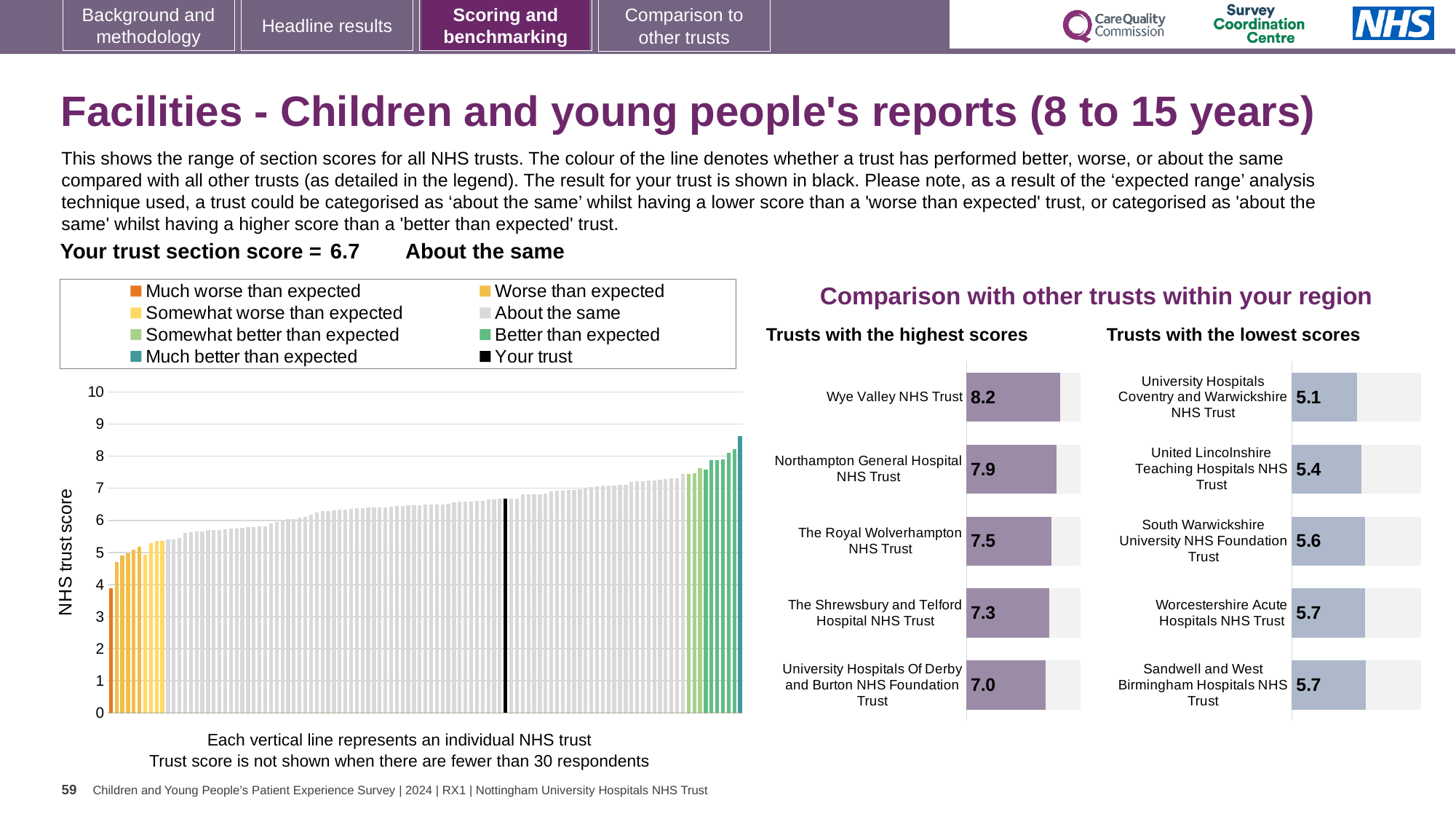
In the main chart of NHS trust scores, is the value for the black 'Your trust' bar greater or less than 6? greater In the 'Trusts with the lowest scores' chart, which trust has the lowest score? University Hospitals Coventry and Warwickshire NHS Trust In the 'Trusts with the highest scores' chart, what is the score for Wye Valley NHS Trust? 8.2 What type of chart is the main chart showing NHS trust scores? Bar chart In the 'Trusts with the lowest scores' chart, what is the difference between the scores of Worcestershire Acute Hospitals NHS Trust and University Hospitals Coventry and Warwickshire NHS Trust? 0.6 How many entries does the legend of the main NHS trust score chart list? 8 In the 'Trusts with the highest scores' chart, what is the score for The Royal Wolverhampton NHS Trust? 7.5 In the 'Trusts with the lowest scores' chart, what is the score for United Lincolnshire Teaching Hospitals NHS Trust? 5.4 In the 'Trusts with the highest scores' chart, which trust has the highest score? Wye Valley NHS Trust How many trusts are shown in the 'Trusts with the lowest scores' chart? 5 In the 'Trusts with the highest scores' chart, what is the difference between the scores of Wye Valley NHS Trust and University Hospitals Of Derby and Burton NHS Foundation Trust? 1.2 In the 'Trusts with the highest scores' chart, which has the larger score: Northampton General Hospital NHS Trust or The Shrewsbury and Telford Hospital NHS Trust? Northampton General Hospital NHS Trust